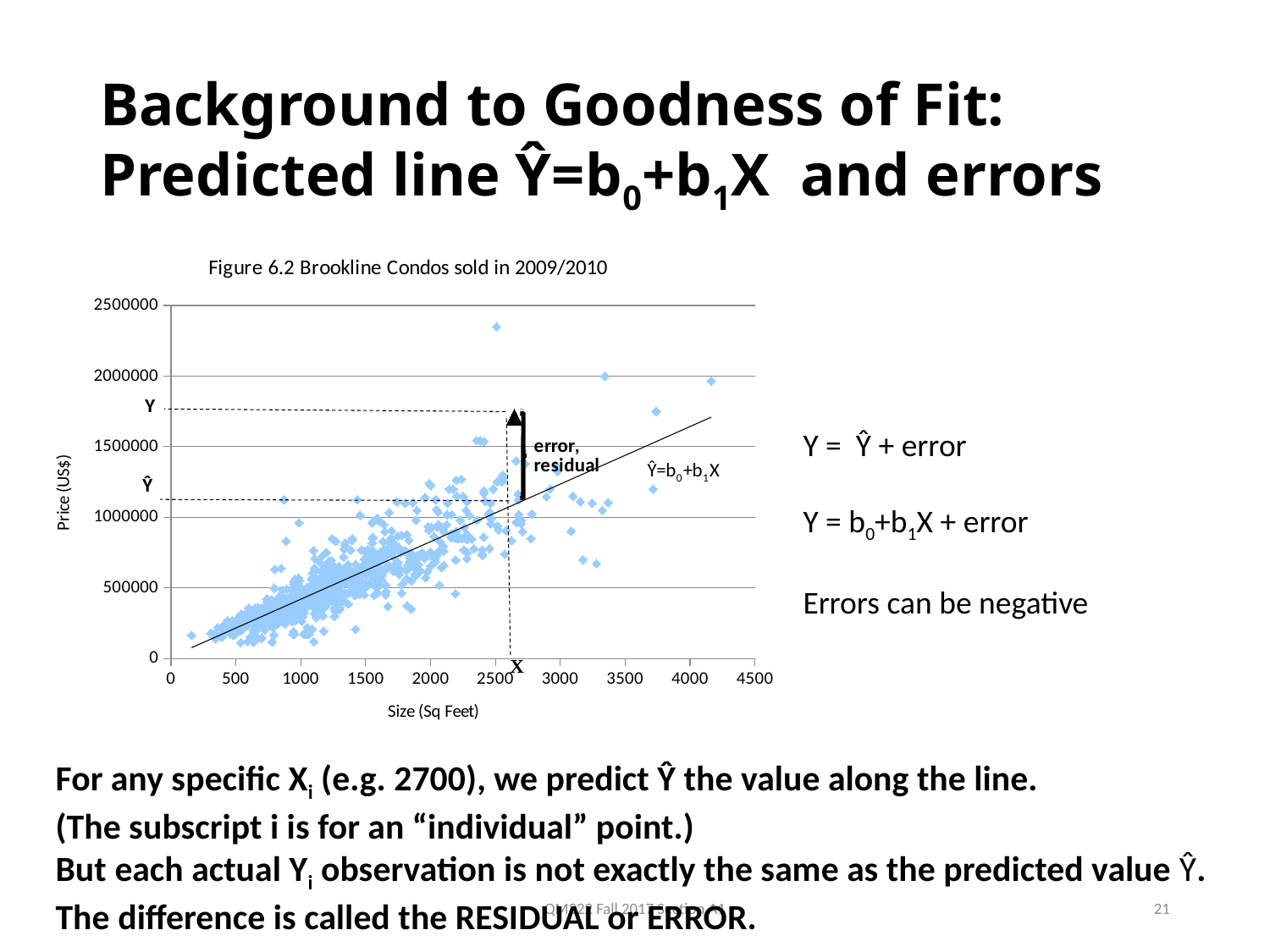
Is the size of the largest condo in the chart greater or less than 4000 square feet? greater Is the price of the highest-priced condo in the chart greater or less than 2500000? less What kind of chart is shown on the slide? scatter plot Is the size of the smallest condo in the chart greater or less than 500 square feet? less What is the title of the chart? Figure 6.2 Brookline Condos sold in 2009/2010 Do condo prices generally rise or fall as size increases along the x axis? rise What is the highest value shown on the y axis of the chart? 2500000 What is the label of the x axis of the chart? Size (Sq Feet) What is the highest value shown on the x axis of the chart? 4500